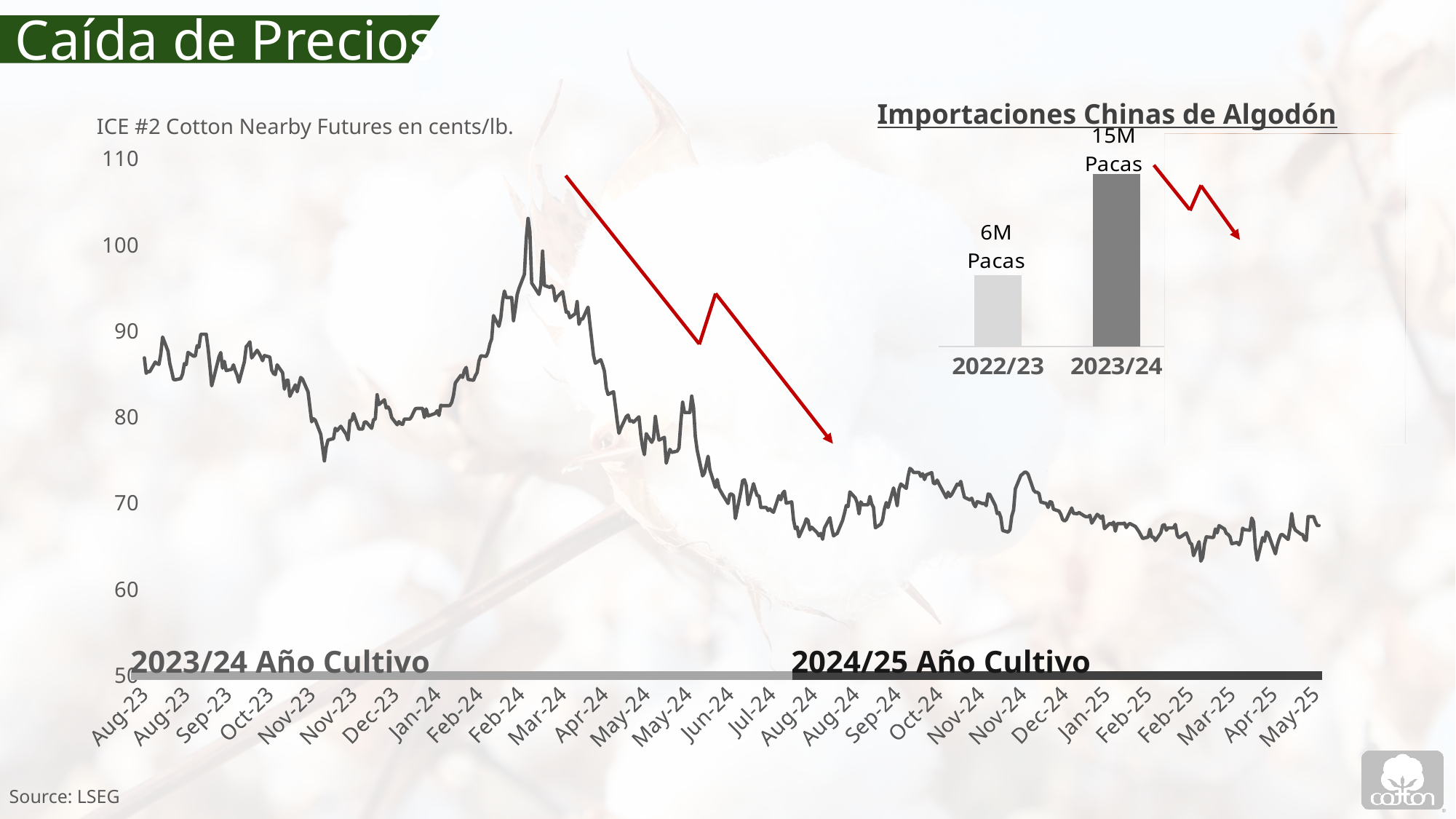
What kind of chart is the 'ICE #2 Cotton Nearby Futures en cents/lb.' chart? line chart In the 'ICE #2 Cotton Nearby Futures' chart, is the value at May-25 greater or less than 70? less In the 'Importaciones Chinas de Algodón' chart, which year has the lowest value? 2022/23 In the 'Importaciones Chinas de Algodón' chart, what is the value for 2022/23? 6M Pacas In the 'Importaciones Chinas de Algodón' chart, what is the difference between the 2023/24 and 2022/23 values? 9M Pacas What kind of chart is the 'Importaciones Chinas de Algodón' chart? bar chart What source is cited for the 'ICE #2 Cotton Nearby Futures' chart? LSEG How many categories are shown in the 'Importaciones Chinas de Algodón' chart? 2 In the 'Importaciones Chinas de Algodón' chart, what is the value for 2023/24? 15M Pacas In the 'Importaciones Chinas de Algodón' chart, which year has the highest value? 2023/24 In the 'ICE #2 Cotton Nearby Futures' chart, do values overall rise or fall from the Feb-24 peak to May-25? fall In the 'ICE #2 Cotton Nearby Futures' chart, is the peak value around Feb-24 greater or less than 100? greater